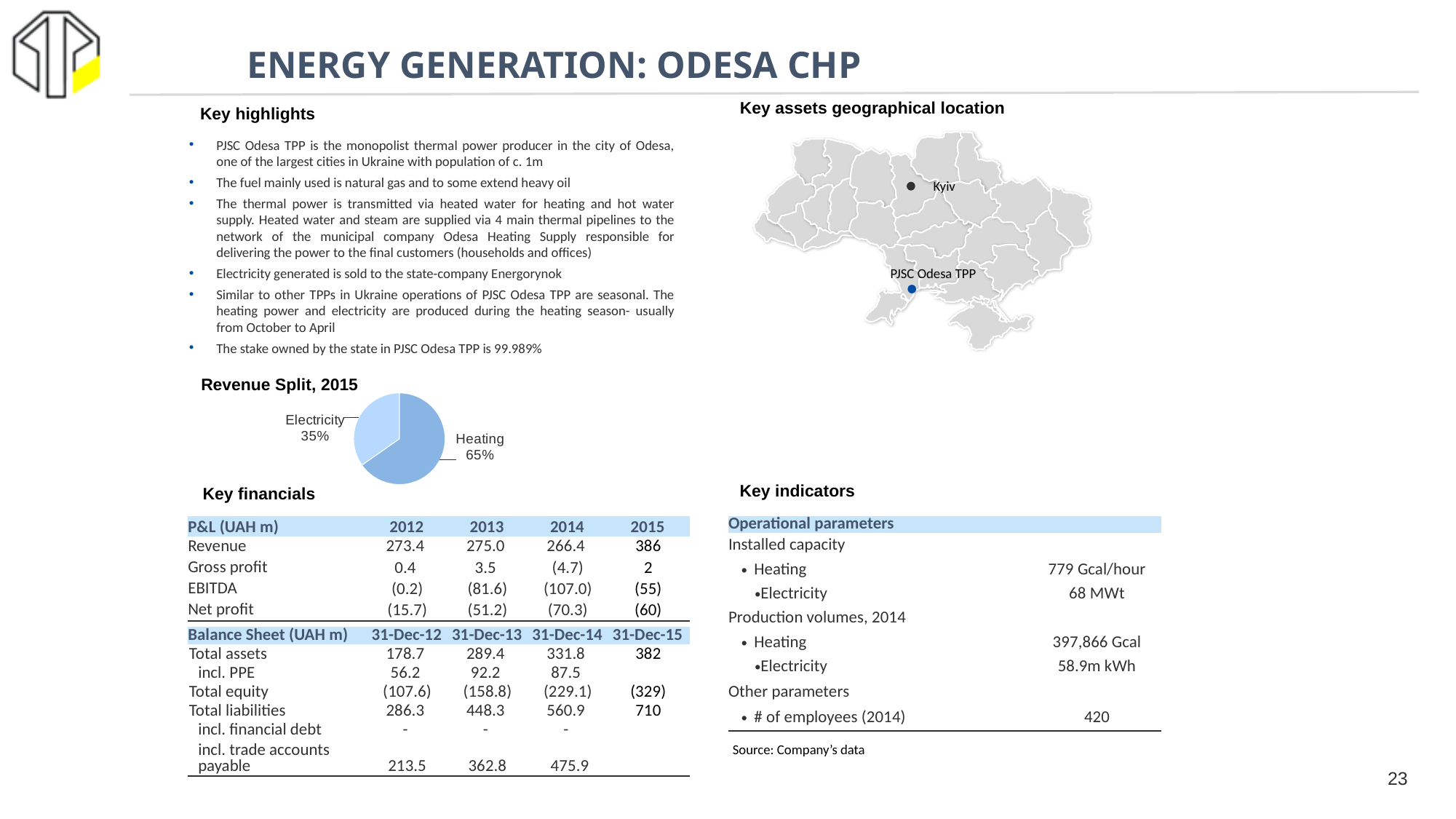
Which slice is the largest in the Revenue Split, 2015 pie chart? Heating What is the title of the pie chart on the slide? Revenue Split, 2015 In the Revenue Split, 2015 pie chart, is the Electricity share greater or less than 50%? less In the Revenue Split, 2015 pie chart, what share of revenue comes from Electricity? 35% How many slices does the Revenue Split, 2015 pie chart have? 2 What are the two categories shown in the Revenue Split, 2015 pie chart? Heating and Electricity What type of chart is used for the Revenue Split, 2015? Pie chart In the Revenue Split, 2015 pie chart, which is larger: the Heating share or the Electricity share? Heating Which slice is the smallest in the Revenue Split, 2015 pie chart? Electricity In the Revenue Split, 2015 pie chart, how many percentage points larger is the Heating share than the Electricity share? 30 percentage points In the Revenue Split, 2015 pie chart, what share of revenue comes from Heating? 65%